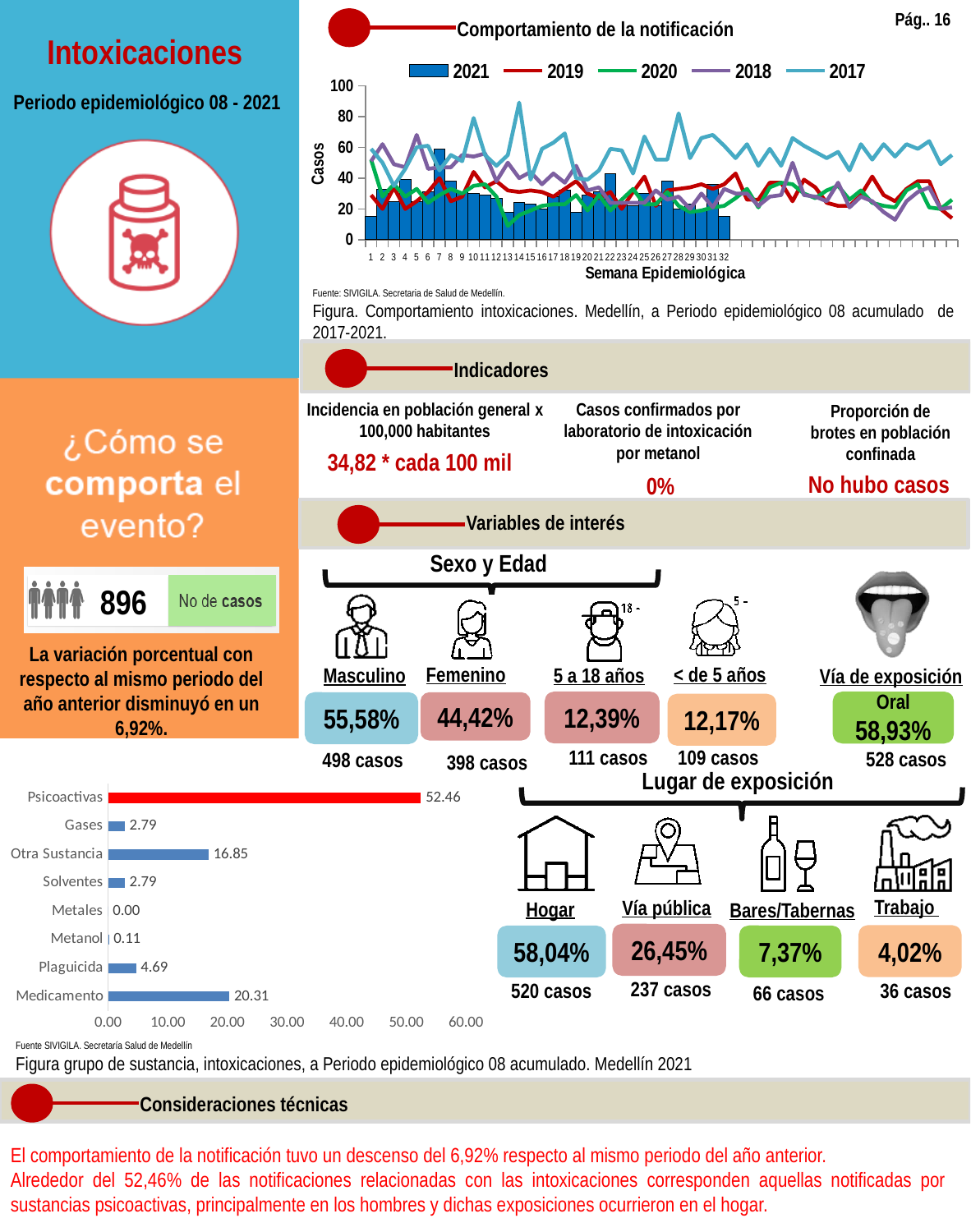
In the bottom bar chart (grupo de sustancia), which is larger, the value for Plaguicida or the value for Gases? Plaguicida In the top chart 'Comportamiento de la notificación', is the 2021 value at week 1 greater or less than 20? less How many categories are shown in the bottom bar chart (grupo de sustancia)? 8 What kind of chart is the bottom chart (grupo de sustancia)? Bar chart How many series does the legend of the top chart 'Comportamiento de la notificación' list? 5 In the bottom bar chart (grupo de sustancia), what is the difference between the values for Psicoactivas and Medicamento? 32.15 In the bottom bar chart (grupo de sustancia), which category has the lowest value? Metales In the bottom bar chart (grupo de sustancia), what is the value for Otra Sustancia? 16.85 In the bottom bar chart (grupo de sustancia), what is the value for Medicamento? 20.31 In the top chart 'Comportamiento de la notificación', is the value for 2017 at week 14 greater or less than 80? greater In the bottom bar chart (grupo de sustancia), which category has the highest value? Psicoactivas In the bottom bar chart (grupo de sustancia), what is the value for Psicoactivas? 52.46